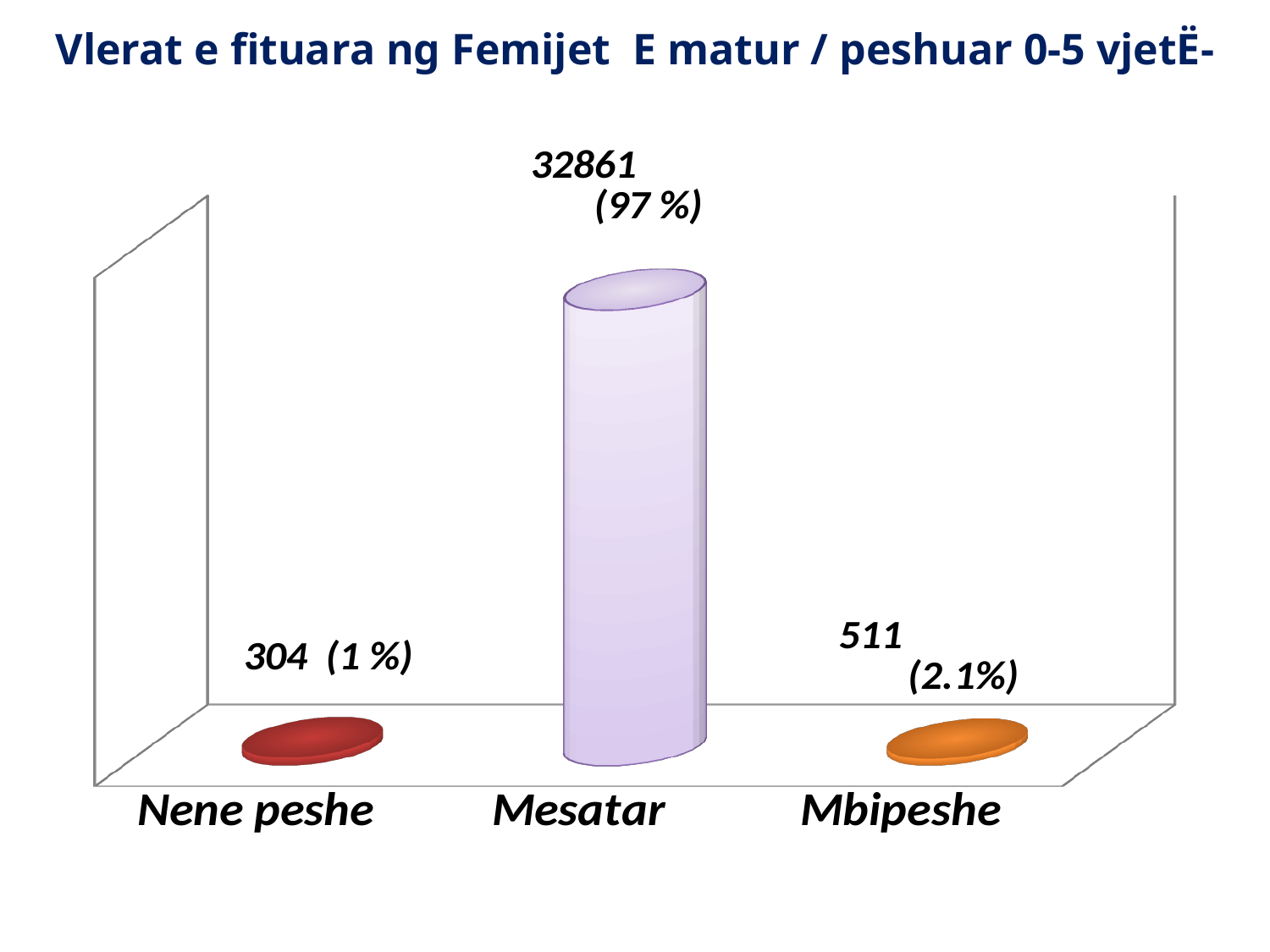
What is the difference between the values for Mesatar and Mbipeshe? 32350 What percentage is shown for Mesatar? 97 % What is the value for Mbipeshe? 511 What is the value for Mesatar? 32861 Which category has the lowest value? Nene peshe What kind of chart is shown on the slide? Bar chart Which category has the highest value? Mesatar Which is larger, the value for Mbipeshe or the value for Nene peshe? Mbipeshe What is the value for Nene peshe? 304 What percentage is shown for Mbipeshe? 2.1% What is the difference between the values for Mbipeshe and Nene peshe? 207 How many categories are shown on the chart? 3